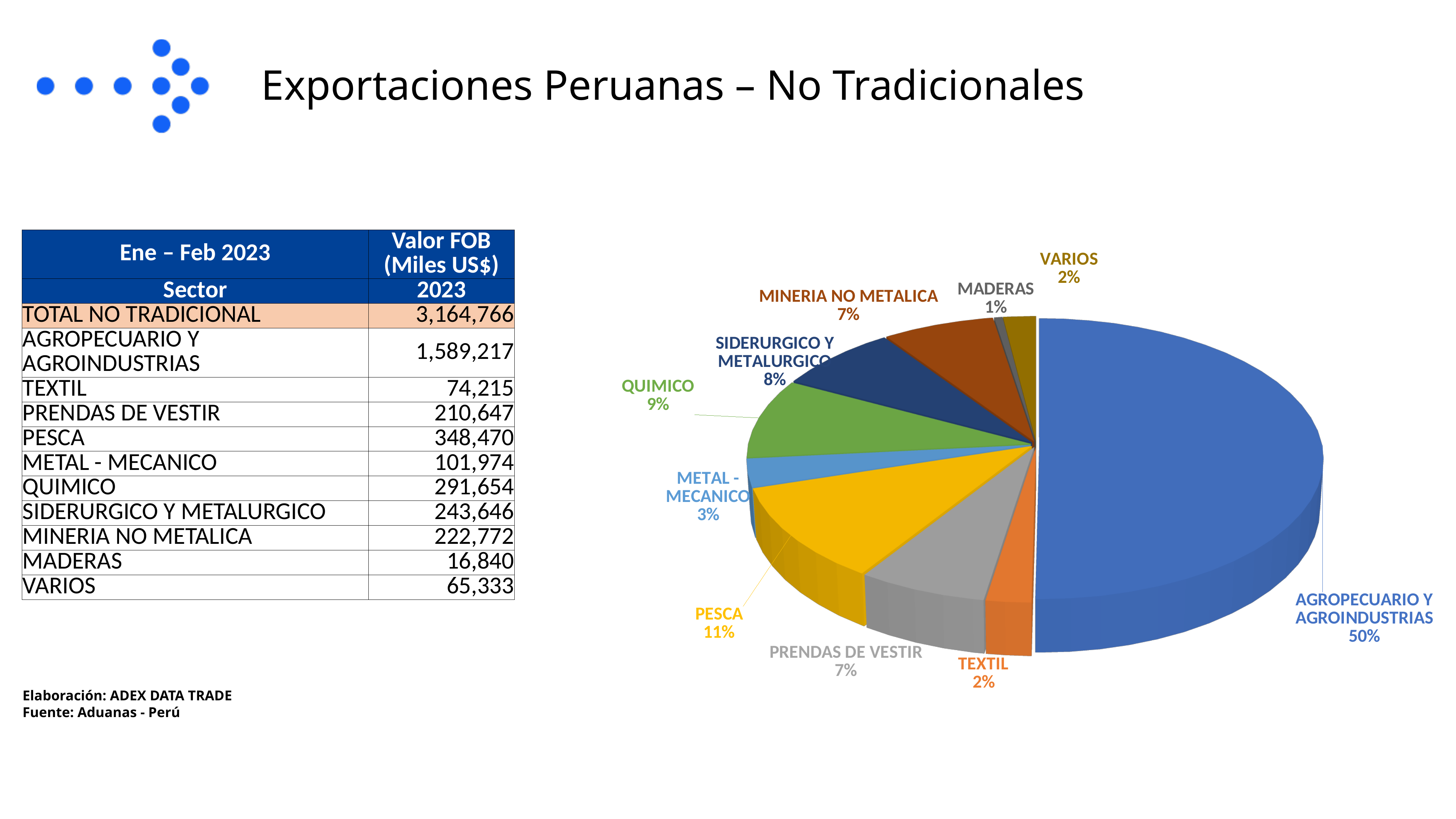
Which sector has the largest slice in the pie chart? AGROPECUARIO Y AGROINDUSTRIAS What share of the pie chart does SIDERURGICO Y METALURGICO represent? 8% What share of the pie chart does PESCA represent? 11% What share of the pie chart does AGROPECUARIO Y AGROINDUSTRIAS represent? 50% Which sector has the smallest slice in the pie chart? MADERAS What type of chart is shown on the slide? Pie chart In the pie chart, which slice is larger, PESCA or QUIMICO? PESCA How many slices does the pie chart have? 10 What is the difference in percentage points between the PESCA slice and the METAL - MECANICO slice in the pie chart? 8 What colour is the AGROPECUARIO Y AGROINDUSTRIAS slice in the pie chart? Blue